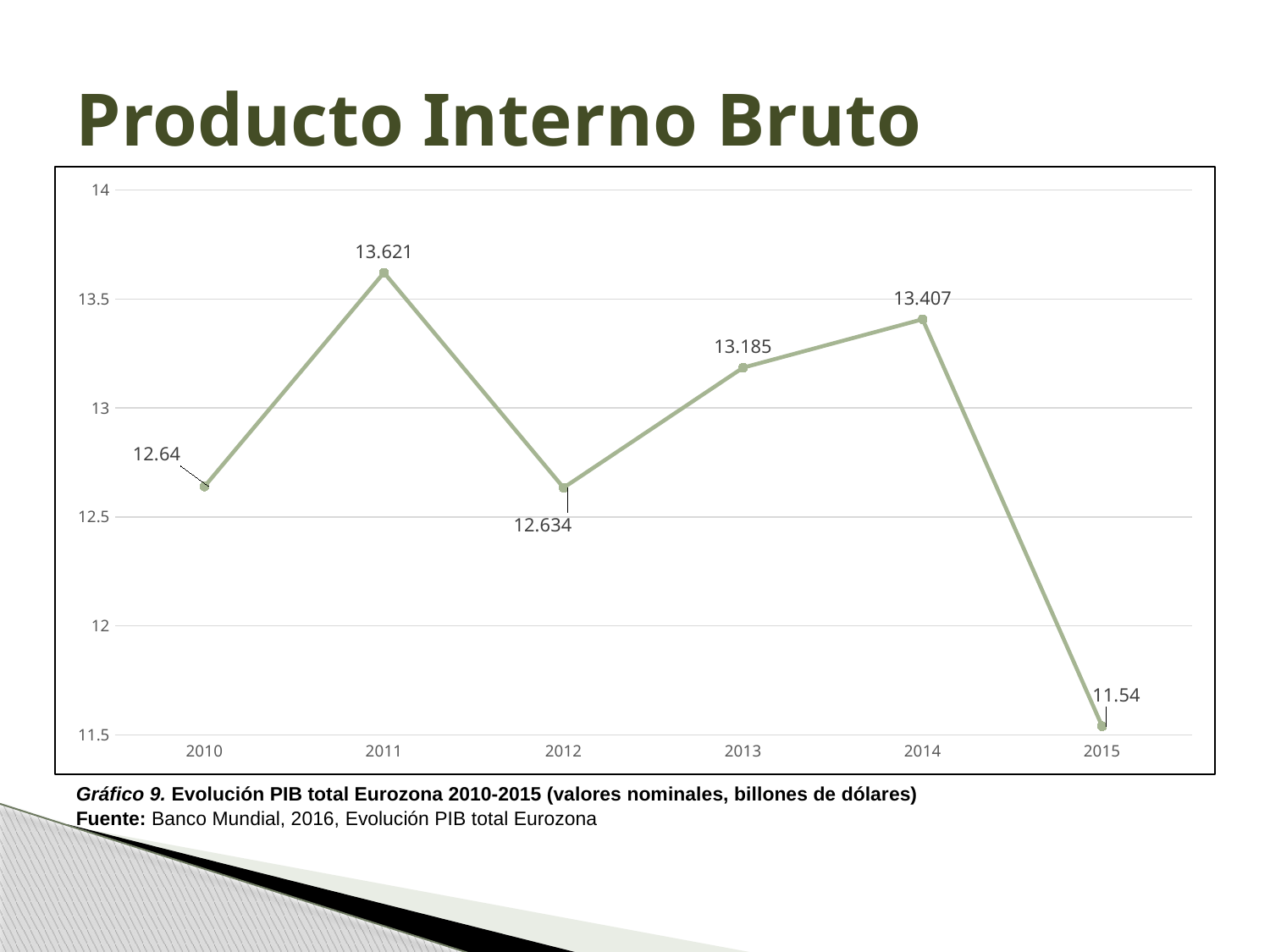
What is the difference between the values for 2014 and 2015? 1.867 What kind of chart is shown on the slide? line chart Does the value rise or fall from 2014 to 2015? fall What is the value for 2015? 11.54 Which year has the highest value? 2011 Which year has the lowest value? 2015 What is the value for 2013? 13.185 How many years are plotted on the chart? 6 What is the value for 2011? 13.621 What is the difference between the values for 2011 and 2010? 0.981 Is the value for 2015 greater or less than 12? less Which is larger, the value for 2014 or the value for 2013? 2014